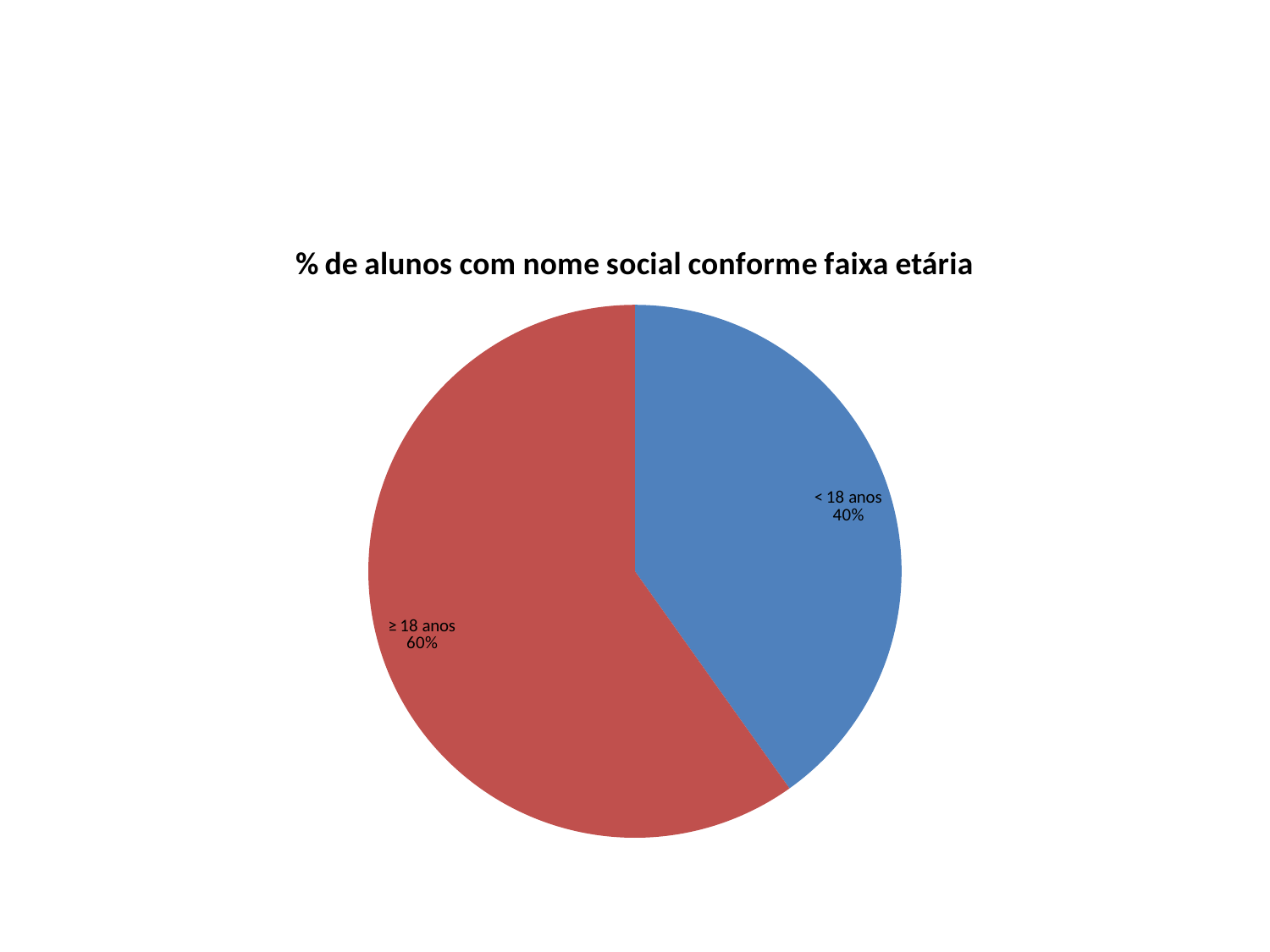
What percentage of the pie is the '≥ 18 anos' slice? 60% What is the difference in percentage points between the '≥ 18 anos' slice and the '< 18 anos' slice? 20 What type of chart is shown on the slide? pie chart What percentage of the pie is the '< 18 anos' slice? 40% Which is larger, the '< 18 anos' slice or the '≥ 18 anos' slice? ≥ 18 anos What share of the pie does the '≥ 18 anos' slice represent? 60% How many slices does the pie chart have? 2 What is the title of the chart? % de alunos com nome social conforme faixa etária Which slice is the smallest in the pie chart? < 18 anos Which slice is the largest in the pie chart? ≥ 18 anos What colour is the '< 18 anos' slice? blue